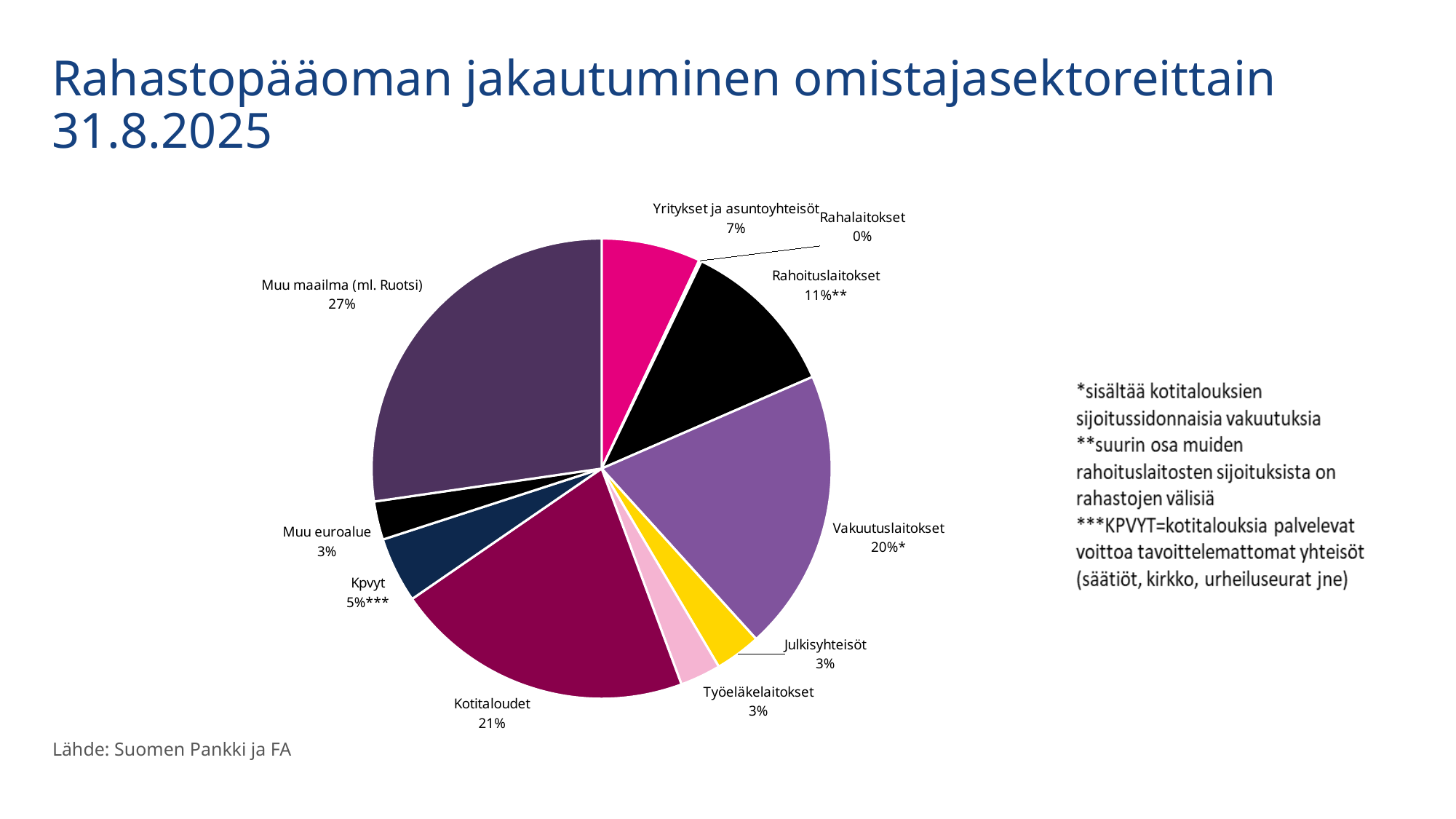
What is the difference in percentage points between Muu maailma (ml. Ruotsi) and Kotitaloudet? 6 Which sector has the largest share of the pie? Muu maailma (ml. Ruotsi) What is the value shown for Kotitaloudet? 21% What is the value shown for Rahoituslaitokset? 11% What share of the pie does Muu maailma (ml. Ruotsi) hold? 27% What is the value shown for Yritykset ja asuntoyhteisöt? 7% What is the value shown for Kpvyt? 5% What kind of chart is shown on the slide? pie chart What is the value shown for Vakuutuslaitokset? 20% Which sector has the smallest share of the pie? Rahalaitokset Which is larger, the share for Kotitaloudet or the share for Vakuutuslaitokset? Kotitaloudet How many sectors are shown in the pie chart? 10